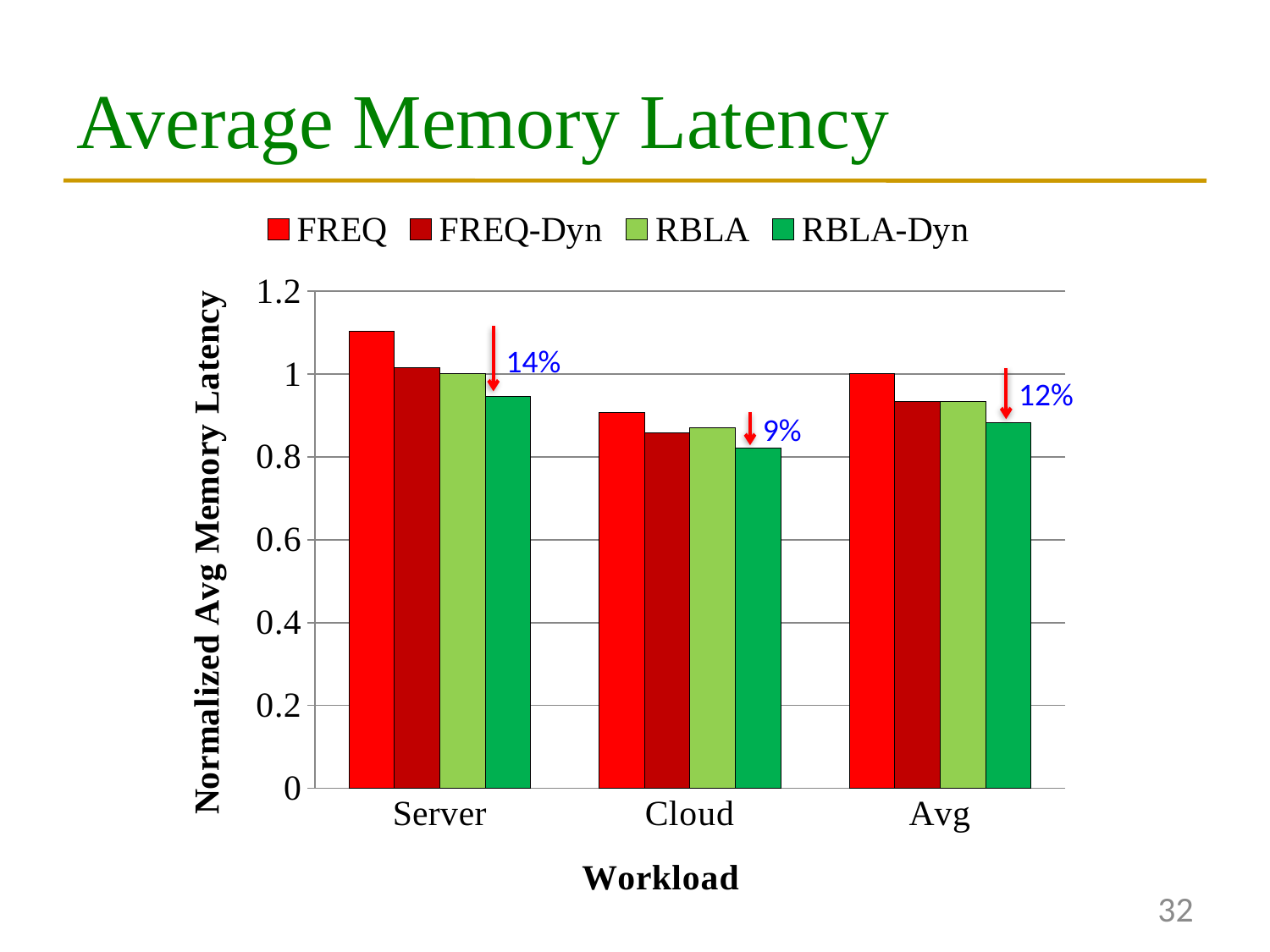
What percentage reduction is annotated above the RBLA-Dyn bar for the Server workload? 14% Is the RBLA-Dyn value for Avg greater or less than 1? less Is the FREQ value for Cloud greater or less than 1? less For the Server workload, which series has the highest normalized average memory latency? FREQ What kind of chart is shown on the slide? bar chart How many series does the legend list? 4 What is the title of the y axis? Normalized Avg Memory Latency Is the FREQ value for Server greater or less than 1? greater For the Cloud workload, which series has the lowest normalized average memory latency? RBLA-Dyn How many workload categories are shown on the x axis? 3 For the Server workload, which series has the lowest normalized average memory latency? RBLA-Dyn Which is larger, the FREQ value for Server or the FREQ value for Cloud? Server